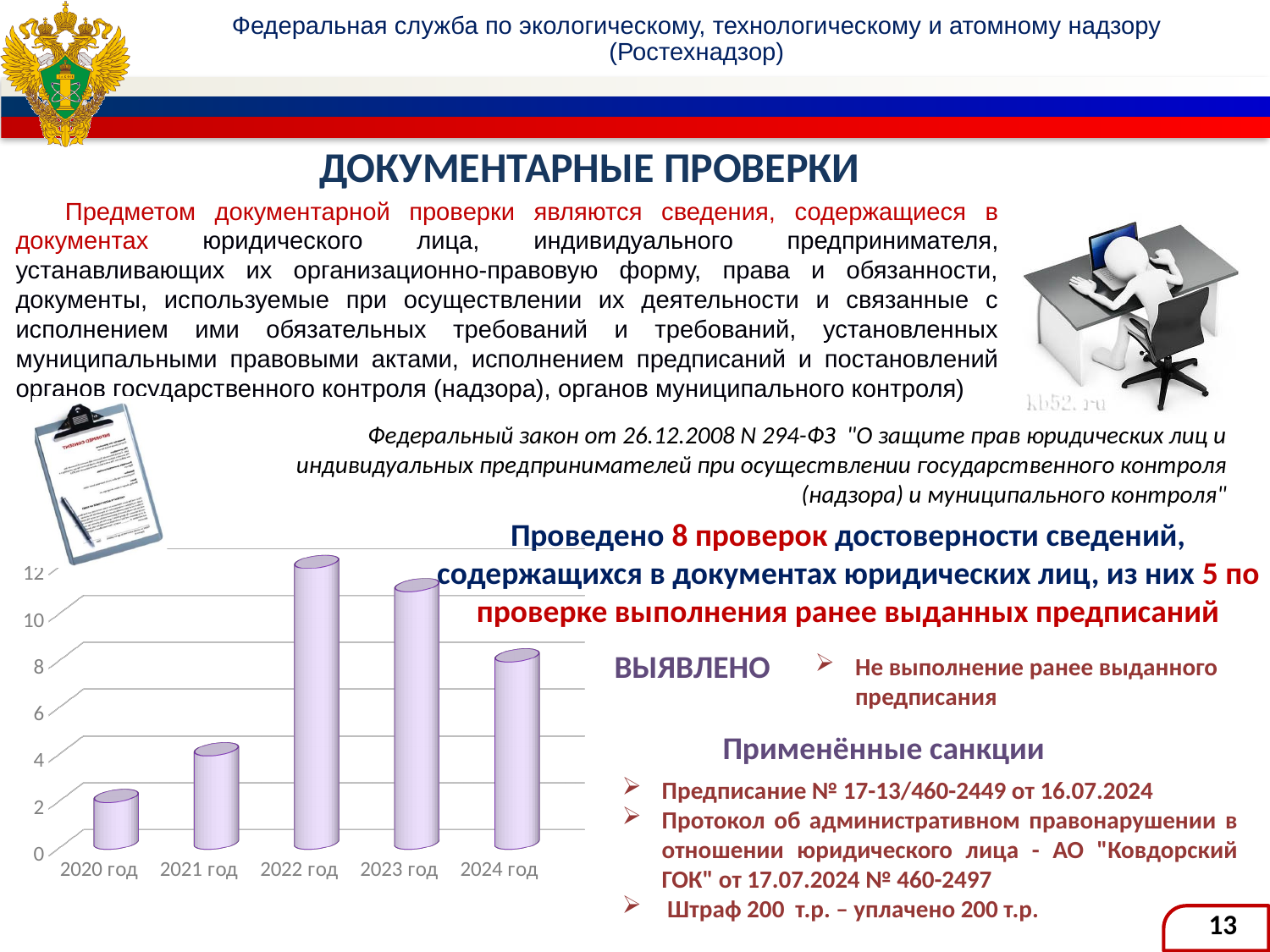
Is the value for 2023 год greater or less than 8? greater Do the values rise or fall from 2020 год to 2022 год? rise Which bar is taller, 2021 год or 2024 год? 2024 год Is the value for 2020 год greater or less than 4? less Which year has the highest bar in the chart? 2022 год Is the value for 2022 год greater or less than 10? greater What is the first category label on the x axis of the chart? 2020 год Which year has the lowest bar in the chart? 2020 год Which bar is taller, 2023 год or 2024 год? 2023 год How many categories (years) are shown on the x axis of the chart? 5 What kind of chart is shown on the slide? bar chart